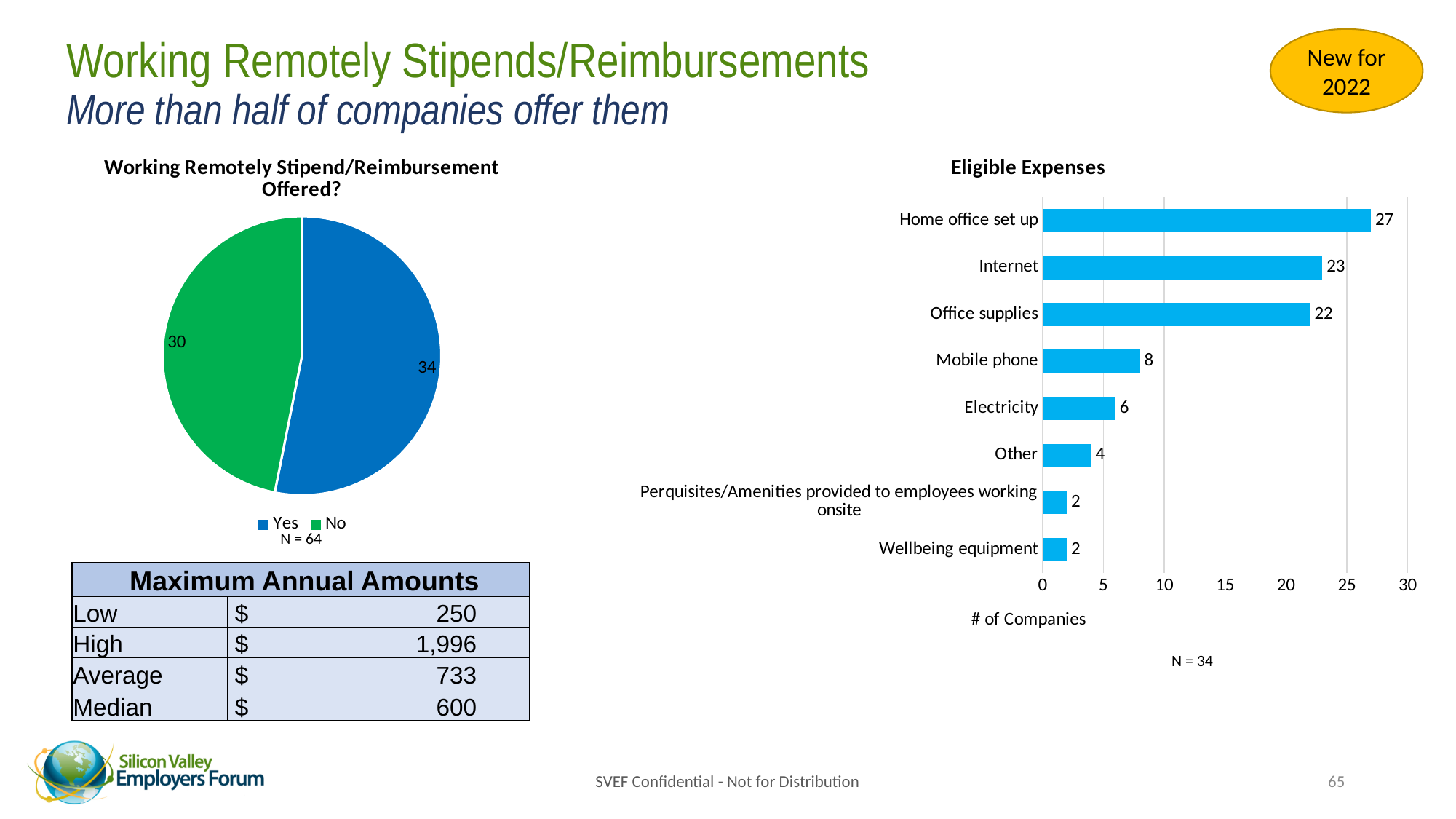
In the 'Working Remotely Stipend/Reimbursement Offered?' pie chart, what is the value for Yes? 34 In the 'Eligible Expenses' chart, how many categories are shown? 8 In the 'Eligible Expenses' chart, what is the value for Internet? 23 In the 'Working Remotely Stipend/Reimbursement Offered?' pie chart, how many entries does the legend list? 2 In the 'Working Remotely Stipend/Reimbursement Offered?' pie chart, which slice is larger, Yes or No? Yes In the 'Eligible Expenses' chart, what is the label on the horizontal axis? # of Companies In the 'Working Remotely Stipend/Reimbursement Offered?' pie chart, what is the value for No? 30 In the 'Eligible Expenses' chart, what is the difference between Home office set up and Office supplies? 5 In the 'Eligible Expenses' chart, which category has the highest value? Home office set up In the 'Eligible Expenses' chart, which is larger, Mobile phone or Electricity? Mobile phone In the 'Eligible Expenses' chart, what kind of chart is shown? bar chart In the 'Working Remotely Stipend/Reimbursement Offered?' chart, what kind of chart is shown? pie chart